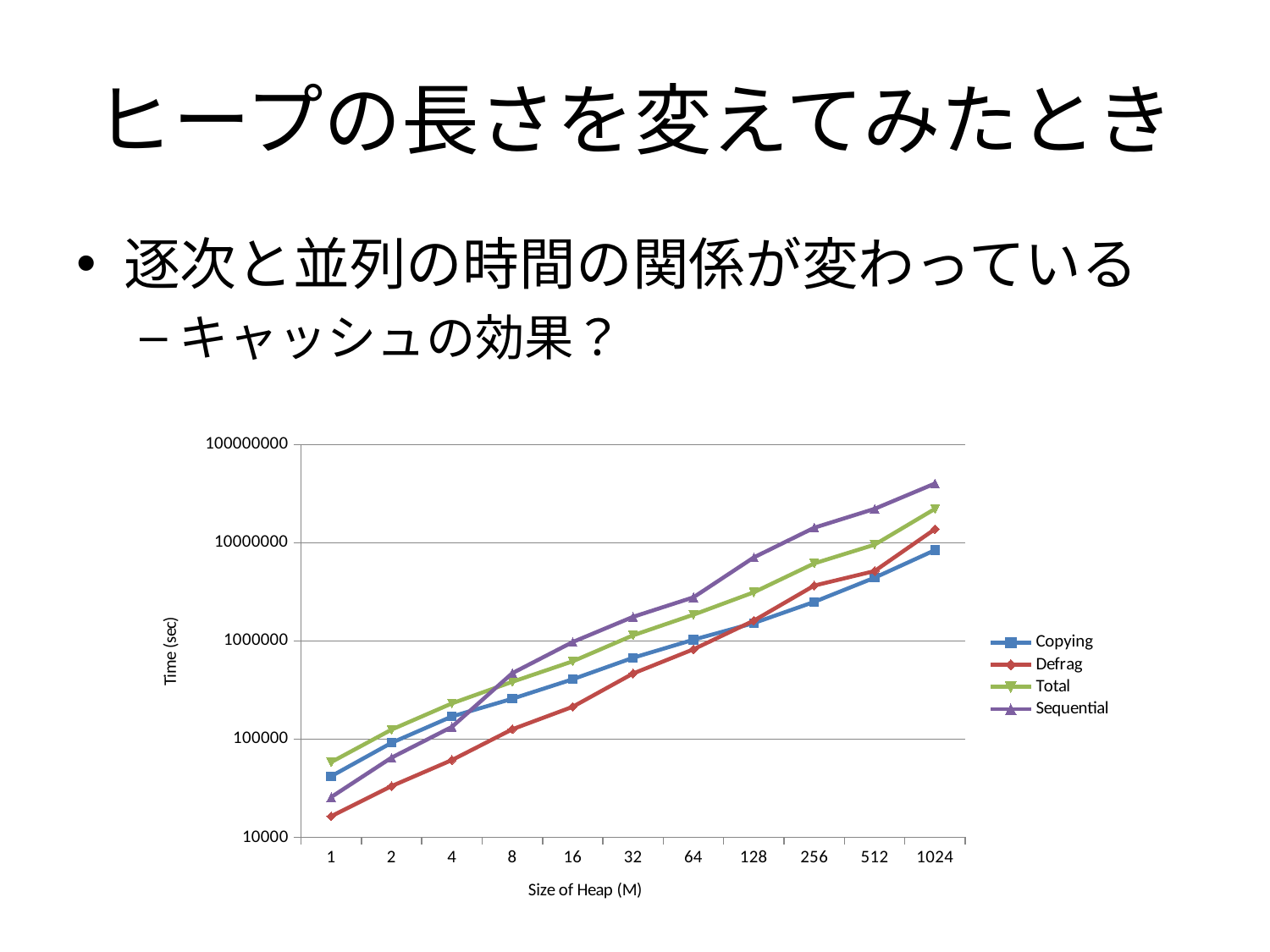
Which series has the highest value at a heap size of 1024? Sequential Which series has the highest value at a heap size of 1? Total How many series does the legend list? 4 What is the label of the x axis? Size of Heap (M) Is the Sequential value at a heap size of 1024 greater or less than 10000000? greater At a heap size of 256, which is larger: the Sequential value or the Total value? Sequential Do the Sequential values rise or fall as the size of heap increases? rise Is the Total value at a heap size of 16 greater or less than 1000000? less How many heap sizes are plotted along the x axis? 11 Which series has the lowest value at a heap size of 1? Defrag Is the Defrag value at a heap size of 1 greater or less than 100000? less What kind of chart is shown on the slide? line chart